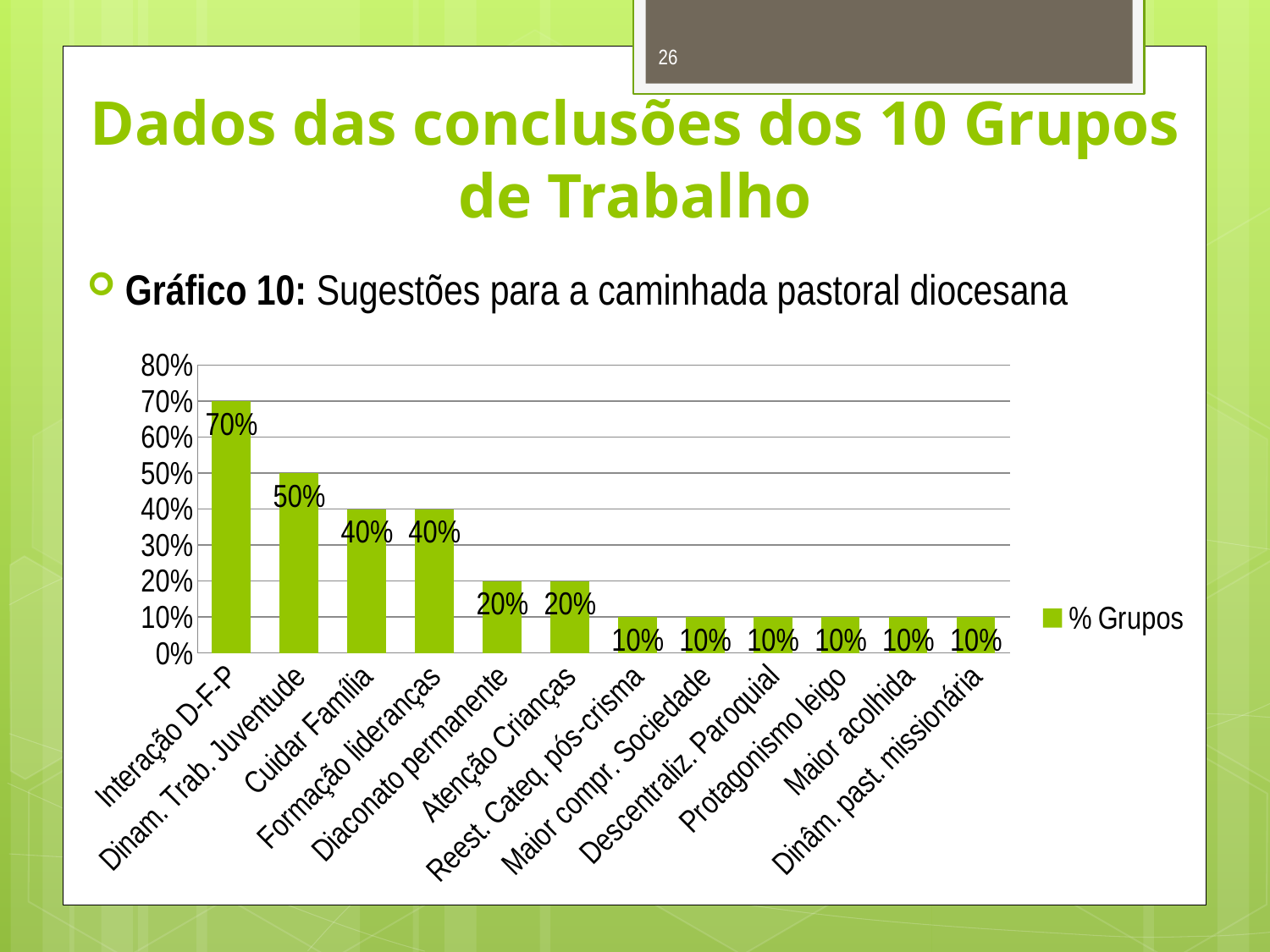
Which is larger, the value for Formação lideranças or the value for Maior acolhida? Formação lideranças What kind of chart is shown on the slide? bar chart How many series does the legend list? 1 What is the difference between the values for Cuidar Família and Atenção Crianças? 20% Is the value for Dinam. Trab. Juventude greater or less than 40%? greater What is the value for Diaconato permanente? 20% How many categories are shown on the x axis? 12 What is the value for Dinam. Trab. Juventude? 50% What is the value for Interação D-F-P? 70% Which category has the highest value? Interação D-F-P What is the value for Protagonismo leigo? 10% What is the difference between the values for Interação D-F-P and Dinam. Trab. Juventude? 20%